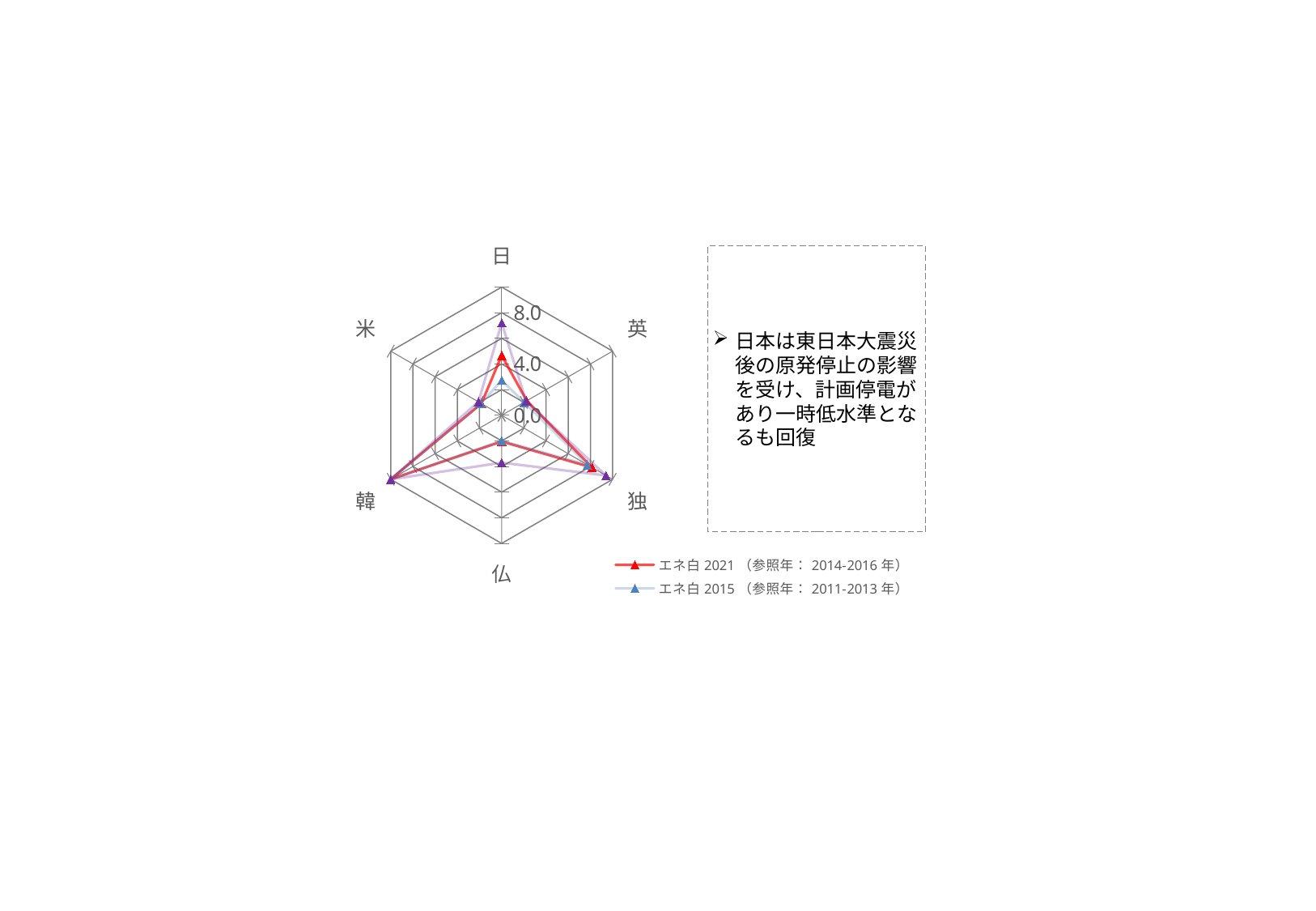
Which category has the highest value for the エネ白 2021 series? 韓 How many categories (axes) does the radar chart have? 6 What kind of chart is shown on the slide? Radar chart Is the value for 独 in the エネ白 2021 series greater or less than 4.0? greater Is the value for 英 in the エネ白 2021 series greater or less than 4.0? less For 日, which series has the larger value: エネ白 2021 or エネ白 2015? エネ白 2021 How many series does the legend list? 2 What is the highest tick value shown on the radar chart's axis? 8.0 Is the value for 日 in the エネ白 2015 series greater or less than 4.0? less For the エネ白 2021 series, which is larger: the value for 韓 or the value for 日? 韓 What reference years are given in the legend for the エネ白 2015 series? 2011-2013年